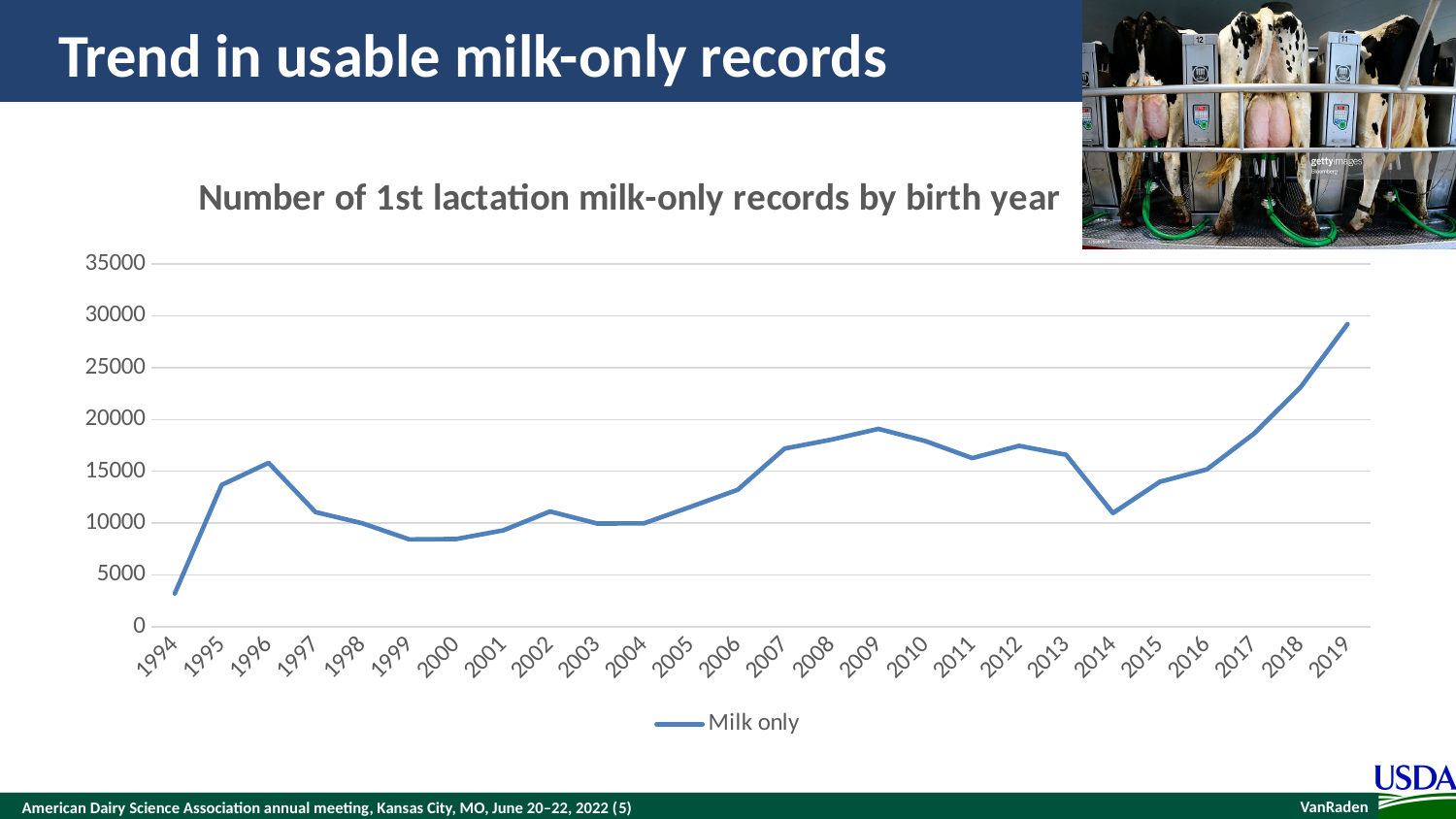
Which birth year has the lowest number of milk-only records? 1994 What kind of chart is shown on the slide? Line chart What is the title of the chart? Number of 1st lactation milk-only records by birth year Is the value for 1999 greater or less than 10000? less Which birth year has the highest number of milk-only records? 2019 Which birth year has more milk-only records, 2009 or 2019? 2019 What is the name of the series shown in the legend? Milk only How many series does the legend list? 1 Is the value for 1994 greater or less than 5000? less How many birth years are plotted on the x axis? 26 Do the values rise or fall from 2014 to 2019? Rise Is the value for 2019 greater or less than 25000? greater